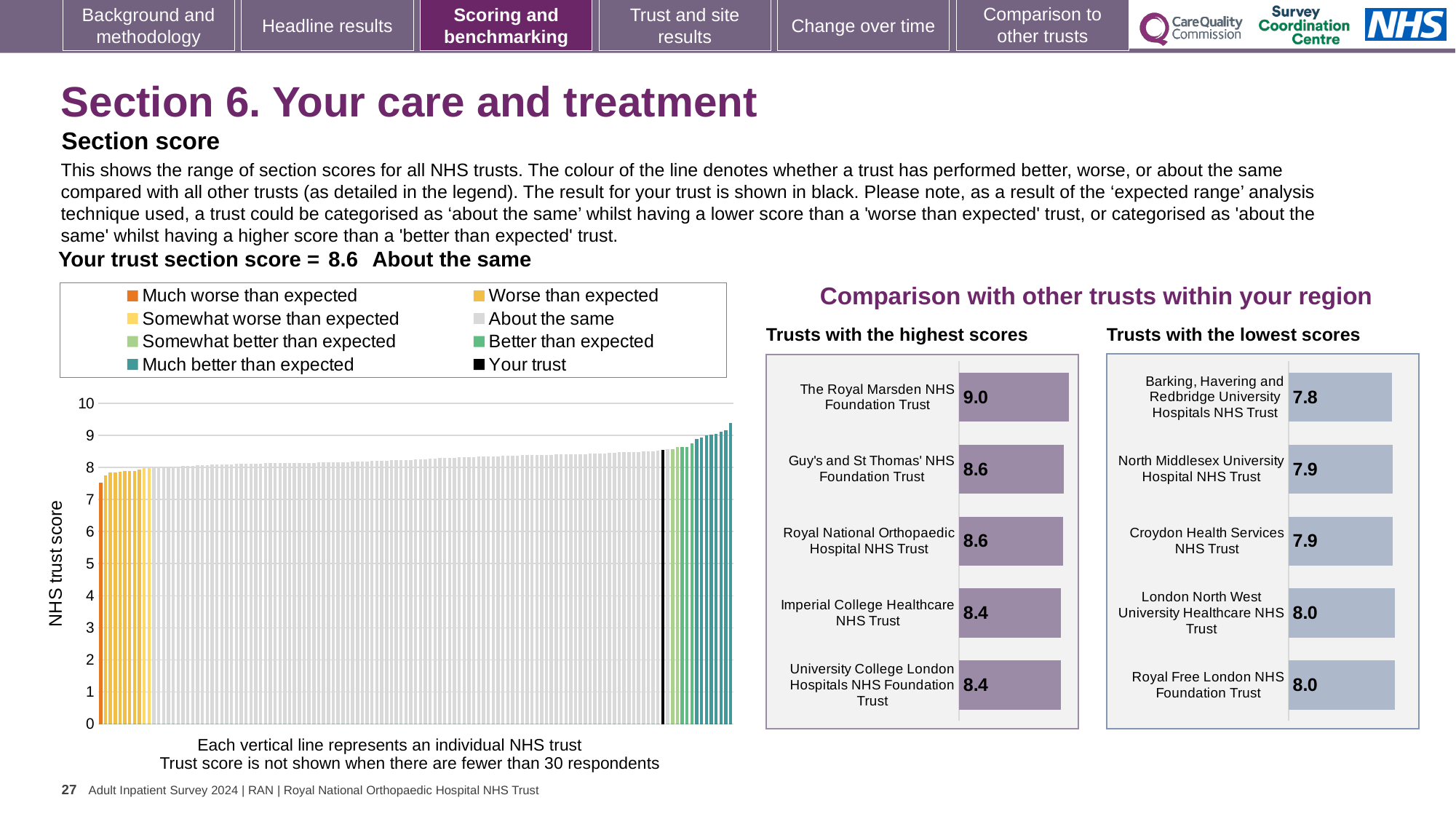
In the 'Trusts with the lowest scores' chart, which trust has the lowest score? Barking, Havering and Redbridge University Hospitals NHS Trust How many trusts are shown in the 'Trusts with the highest scores' chart? 5 In the 'Trusts with the highest scores' chart, which trust has the highest score? The Royal Marsden NHS Foundation Trust In the large chart on the left, do the trust scores rise or fall from left to right? Rise What kind of chart is the large chart on the left showing NHS trust scores? Bar chart How many entries does the legend of the large chart on the left list? 8 In the 'Trusts with the highest scores' chart, what is the score for The Royal Marsden NHS Foundation Trust? 9.0 In the 'Trusts with the highest scores' chart, what is the difference between the scores of The Royal Marsden NHS Foundation Trust and Imperial College Healthcare NHS Trust? 0.6 What is the y-axis label of the large chart on the left? NHS trust score In the 'Trusts with the lowest scores' chart, which has the larger score: Royal Free London NHS Foundation Trust or Barking, Havering and Redbridge University Hospitals NHS Trust? Royal Free London NHS Foundation Trust How many trusts are shown in the 'Trusts with the lowest scores' chart? 5 In the 'Trusts with the lowest scores' chart, what is the score for Barking, Havering and Redbridge University Hospitals NHS Trust? 7.8